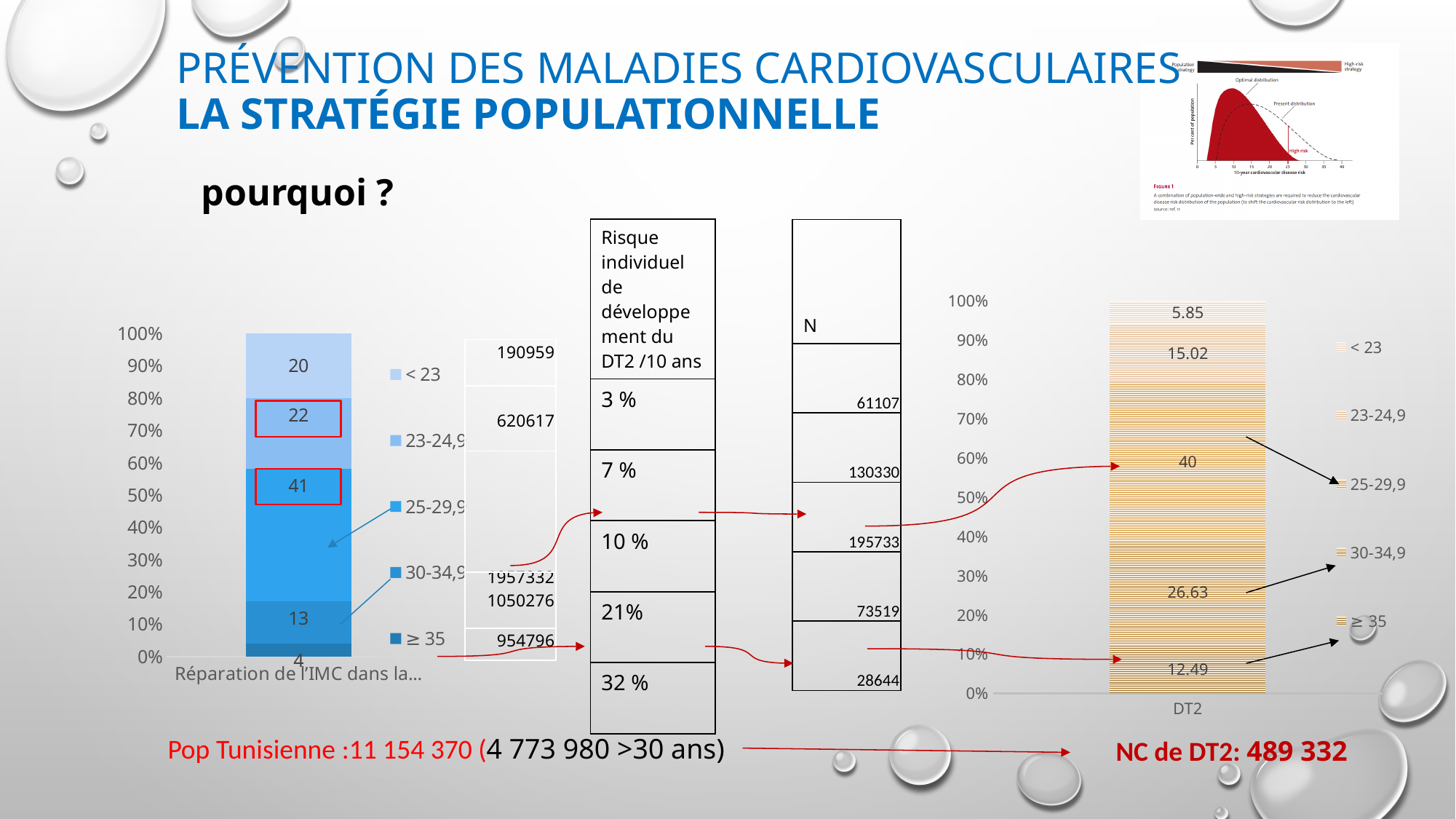
In the right chart (DT2), which is larger: the 23-24,9 segment or the 30-34,9 segment? 30-34,9 In the right chart (DT2), what is the value of the 30-34,9 segment? 26.63 What kind of chart is the left chart (Réparation de l'IMC)? Stacked bar chart In the right chart (DT2), what is the value of the ≥ 35 segment? 12.49 In the right chart (DT2), which BMI category has the smallest segment? < 23 In the left chart (Réparation de l'IMC), which BMI category has the smallest segment? ≥ 35 In the left chart (Réparation de l'IMC), what is the value of the < 23 segment? 20 In the left chart (Réparation de l'IMC), which BMI category has the largest segment? 25-29,9 In the left chart (Réparation de l'IMC), what is the value of the 25-29,9 segment? 41 In the left chart (Réparation de l'IMC), what is the difference between the 25-29,9 segment and the 30-34,9 segment? 28 In the right chart (DT2), which BMI category has the largest segment? 25-29,9 How many series does the legend of the right chart (DT2) list? 5